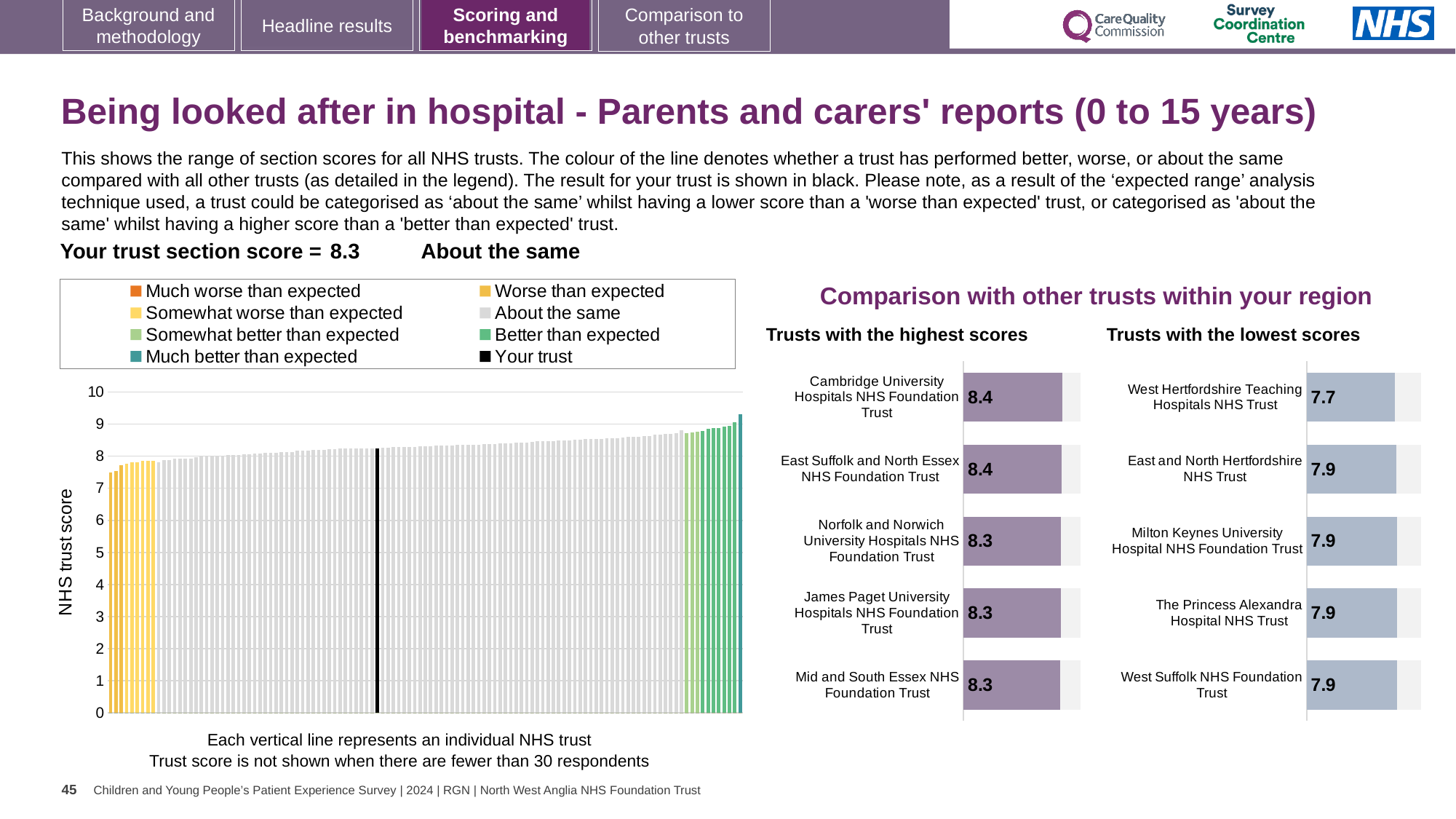
In the 'Trusts with the highest scores' chart, what is the score for Cambridge University Hospitals NHS Foundation Trust? 8.4 In the 'Trusts with the highest scores' chart, what is the score for Mid and South Essex NHS Foundation Trust? 8.3 In the large chart on the left, is the value of the lowest (leftmost) bar greater or less than 8? less What is the y-axis label of the large chart on the left? NHS trust score How many entries does the legend of the large chart on the left list? 8 What is the difference between the score for Cambridge University Hospitals NHS Foundation Trust in the 'highest scores' chart and West Hertfordshire Teaching Hospitals NHS Trust in the 'lowest scores' chart? 0.7 What kind of chart is the large chart on the left showing all NHS trusts? Bar chart How many trusts are listed in the 'Trusts with the lowest scores' chart? 5 In the 'Trusts with the highest scores' chart, which is larger: the score for Cambridge University Hospitals NHS Foundation Trust or for Norfolk and Norwich University Hospitals NHS Foundation Trust? Cambridge University Hospitals NHS Foundation Trust In the 'Trusts with the lowest scores' chart, which trust has the lowest score? West Hertfordshire Teaching Hospitals NHS Trust How many trusts are listed in the 'Trusts with the highest scores' chart? 5 In the 'Trusts with the lowest scores' chart, what is the score for West Hertfordshire Teaching Hospitals NHS Trust? 7.7